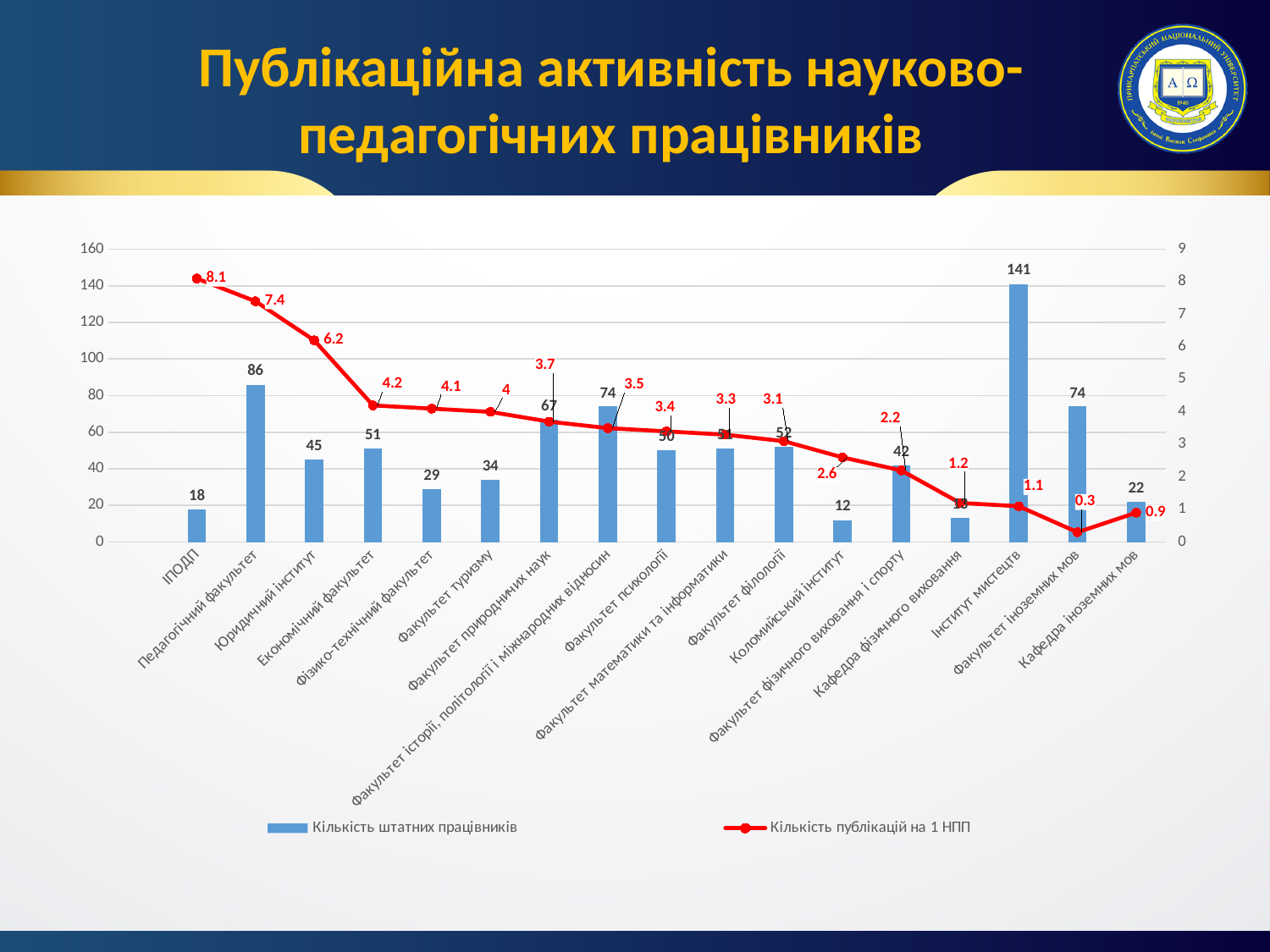
How many series does the legend list? 2 How many full-time staff (Кількість штатних працівників) does Педагогічний факультет have? 86 What is the number of publications per 1 НПП for Факультет туризму? 4 Is the number of full-time staff for Коломийський інститут greater or less than 20? less Which unit has the highest number of full-time staff? Інститут мистецтв How many units (categories) are shown on the x axis? 17 Which has more full-time staff, Економічний факультет or Фізико-технічний факультет? Економічний факультет Does the number of publications per 1 НПП generally rise or fall from left to right along the x axis? fall What kind of chart is shown on the slide? Combined bar and line chart What is the number of publications per 1 НПП for ІПОДП? 8.1 Which unit has the lowest number of publications per 1 НПП? Факультет іноземних мов What is the difference in full-time staff between Інститут мистецтв and Факультет іноземних мов? 67